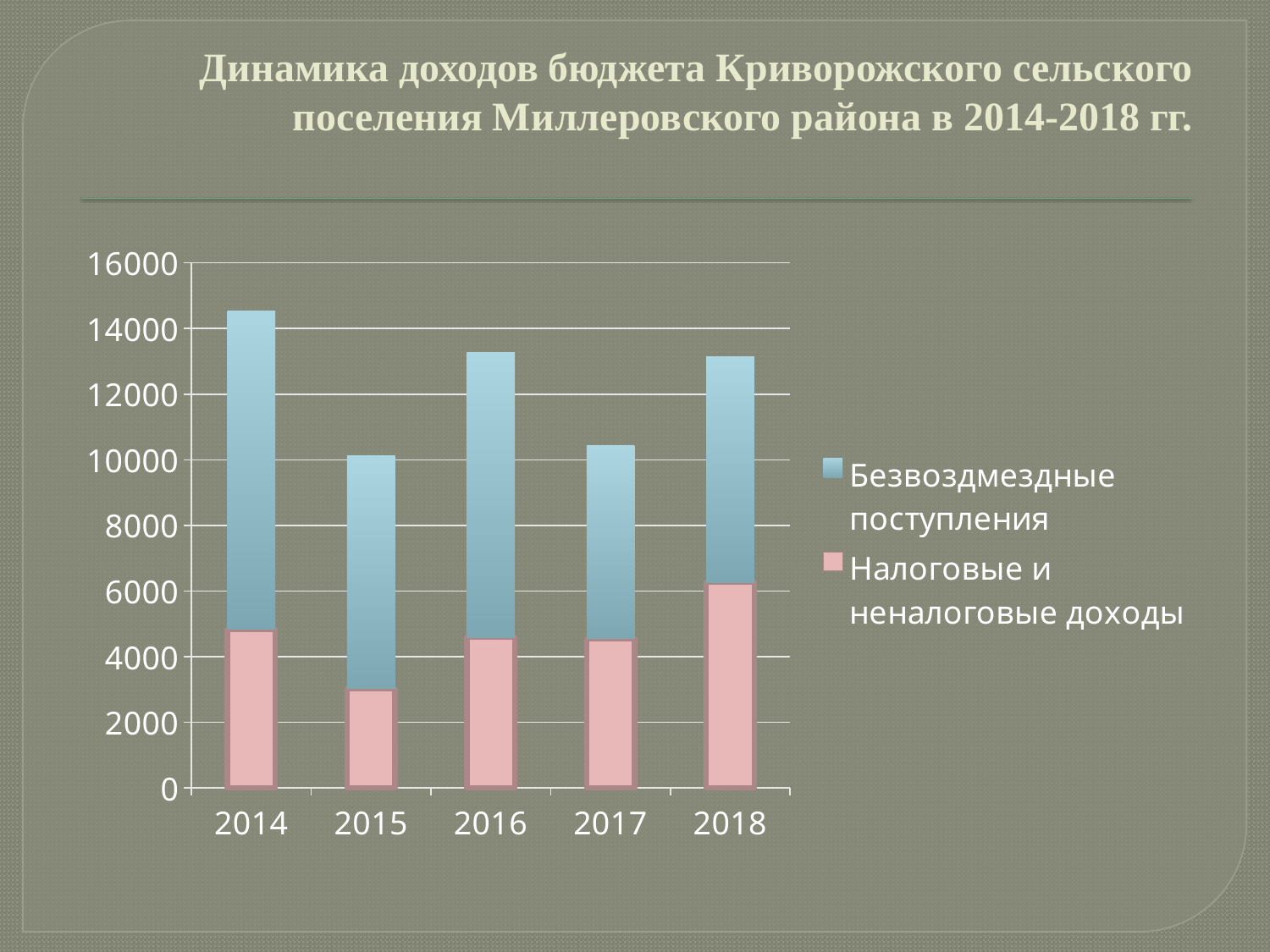
In which year is the value for 'Налоговые и неналоговые доходы' the lowest? 2015 Is the total bar for 2014 greater or less than 14000? greater Which year has the highest total bar in the chart? 2014 In which year is the value for 'Налоговые и неналоговые доходы' the highest? 2018 Which series is shown in pink in the chart? Налоговые и неналоговые доходы Is the value for 'Налоговые и неналоговые доходы' in 2015 greater or less than 4000? less Which year has a larger total bar, 2014 or 2016? 2014 How many years are shown on the x axis of the chart? 5 How many series does the chart legend list? 2 What kind of chart is shown on the slide? stacked bar chart Which year has the lowest total bar in the chart? 2015 Is the total bar for 2017 greater or less than 12000? less